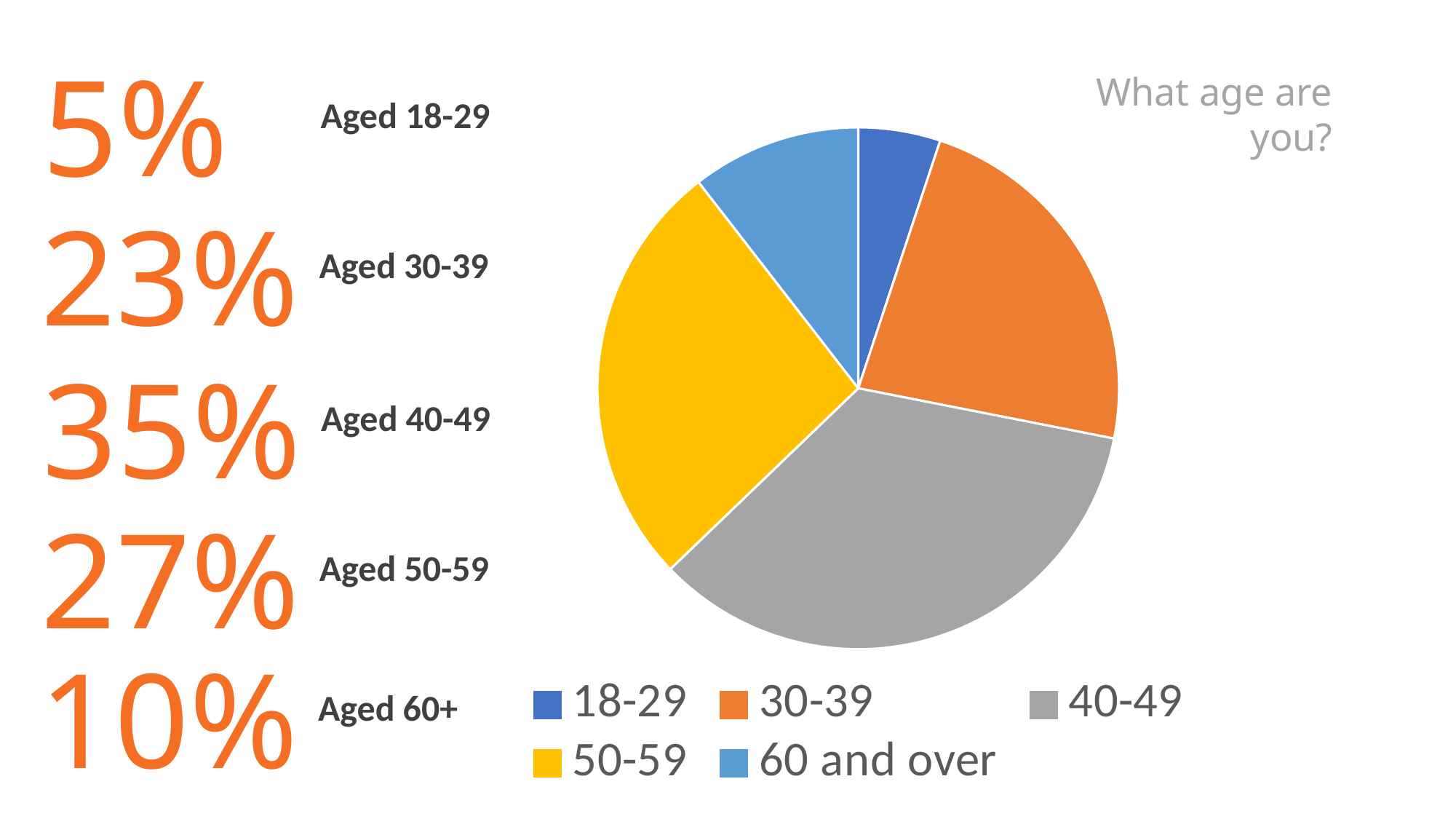
What share of respondents are aged 60 and over? 10% What is the difference between the share for 40-49 and the share for 30-39? 12% Which age group has the smallest share of the pie? 18-29 What kind of chart is shown on the slide? pie chart What share of respondents are aged 18-29? 5% Which is larger, the share for 30-39 or the share for 50-59? 50-59 What share of respondents are aged 40-49? 35% What is the difference between the share for 50-59 and the share for 60 and over? 17% Which age group has the largest share of the pie? 40-49 What is the chart's title? What age are you? Which colour represents the 50-59 age group in the pie chart? yellow How many slices does the pie chart have? 5